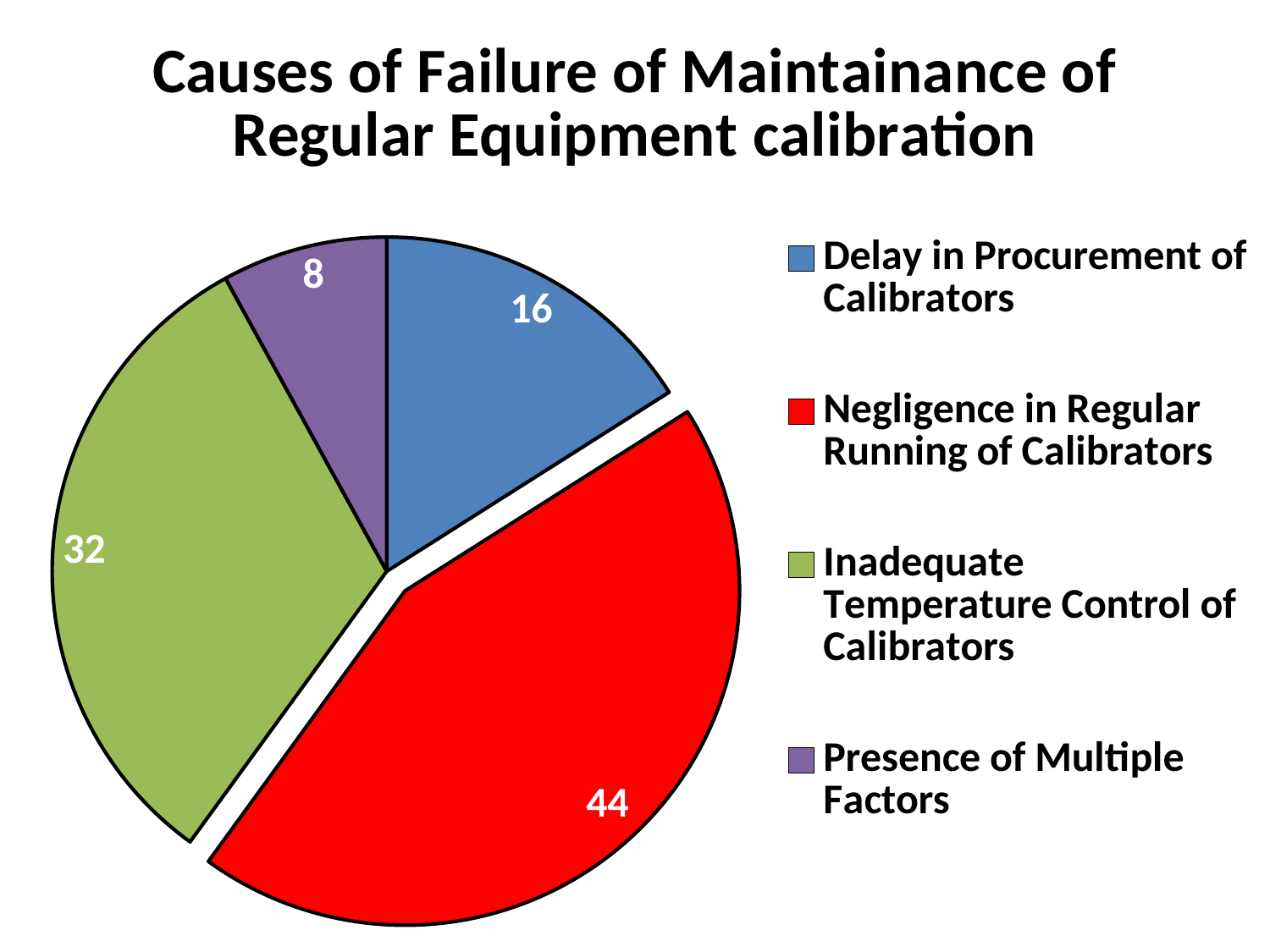
What value is shown for Inadequate Temperature Control of Calibrators? 32 What share of the pie does Negligence in Regular Running of Calibrators represent? 44% What is the difference between the values for Negligence in Regular Running of Calibrators and Inadequate Temperature Control of Calibrators? 12 How many categories are shown in the pie chart? 4 What kind of chart is shown on the slide? Pie chart What colour is the slice for Inadequate Temperature Control of Calibrators? Green What value is shown for Delay in Procurement of Calibrators? 16 Which category has the smallest slice of the pie? Presence of Multiple Factors What value is shown for Presence of Multiple Factors? 8 Which is larger: the value for Delay in Procurement of Calibrators or the value for Presence of Multiple Factors? Delay in Procurement of Calibrators Which category has the largest slice of the pie? Negligence in Regular Running of Calibrators What value is shown for Negligence in Regular Running of Calibrators? 44